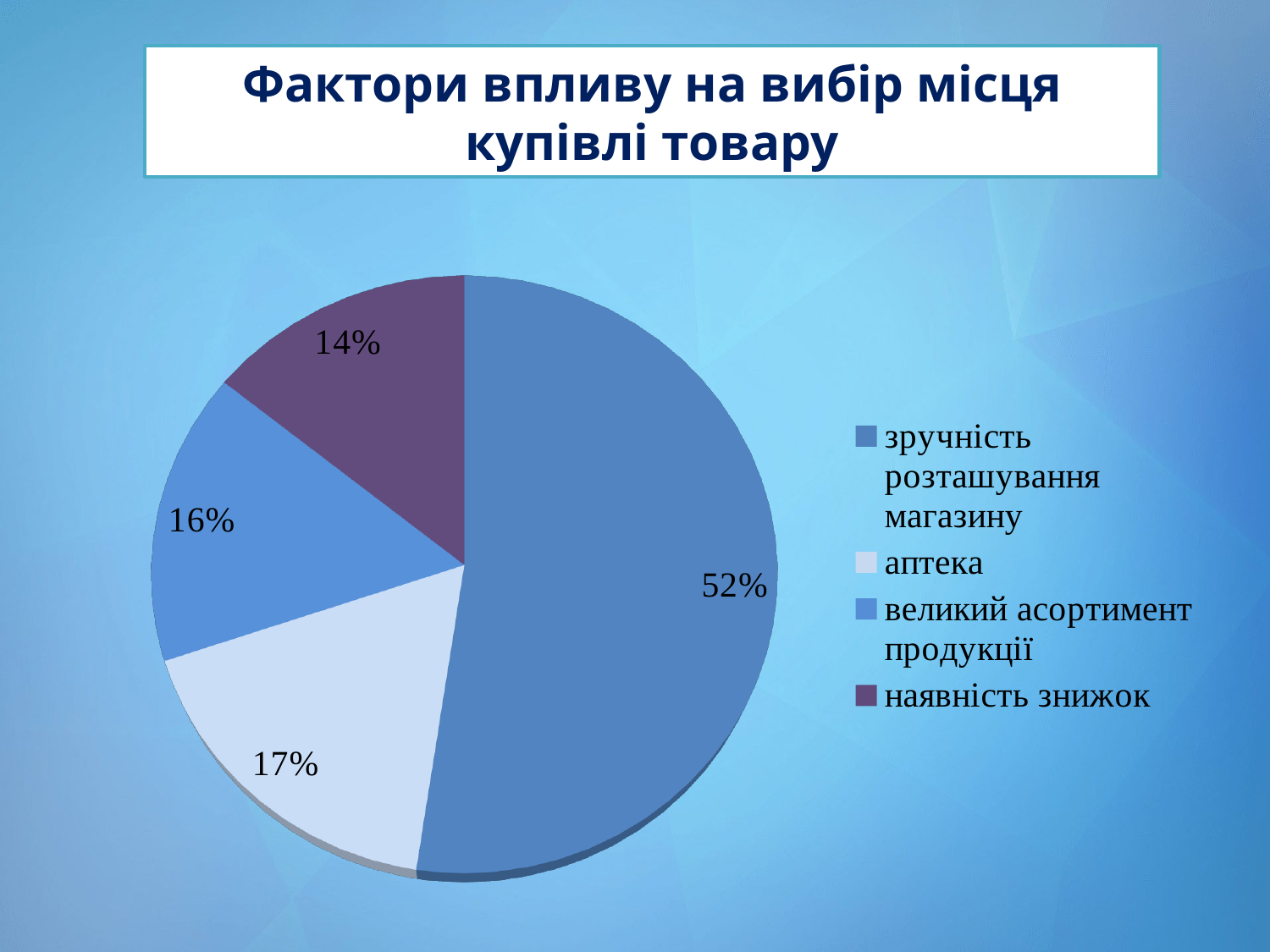
What is the difference in percentage points between "аптека" and "великий асортимент продукції"? 1 What is the title of the slide containing the chart? Фактори впливу на вибір місця купівлі товару Which is larger: the share for "аптека" or the share for "наявність знижок"? аптека How many slices does the pie chart have? 4 Which factor has the smallest slice of the pie? наявність знижок What share of the pie does "зручність розташування магазину" account for? 52% What percentage is shown for "наявність знижок"? 14% Which factor has the largest slice of the pie? зручність розташування магазину What percentage is shown for "великий асортимент продукції"? 16% What is the difference in percentage points between "зручність розташування магазину" and "наявність знижок"? 38 What percentage is shown for "аптека"? 17% What type of chart is shown on the slide? pie chart